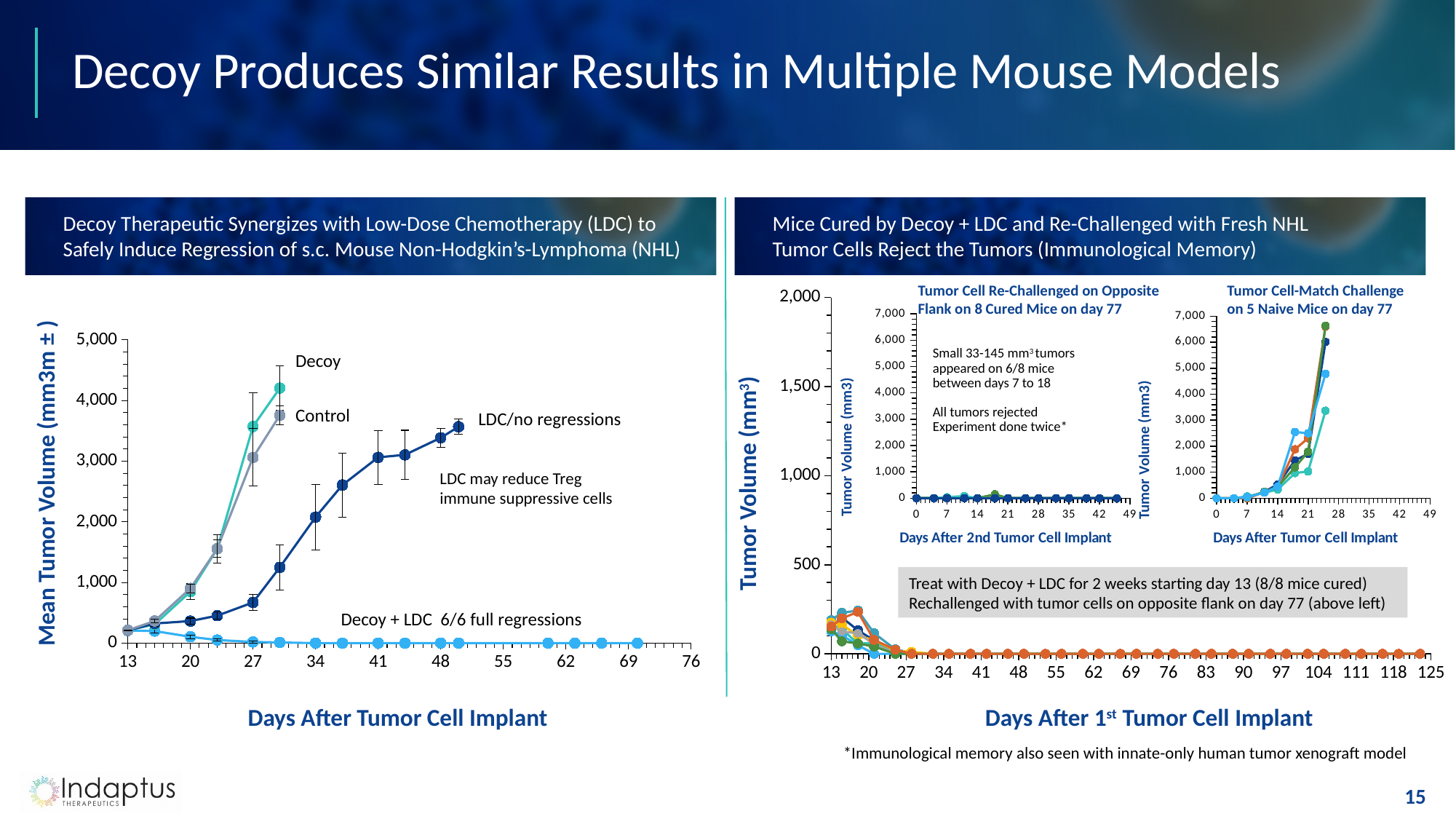
In the left chart, which series stays lowest over the course of the experiment? Decoy + LDC In the left chart, at day 27, which is larger: the Decoy value or the Control value? Decoy In the left chart, which series reaches the highest mean tumor volume? Decoy What kind of chart is the left chart titled 'Days After Tumor Cell Implant'? line chart In the left chart, is the Decoy value at day 27 greater or less than 3,000? greater What is the x-axis label of the right main chart? Days After 1st Tumor Cell Implant In the left chart, does the LDC/no regressions series rise or fall as days increase? rise In the right main chart, are the tumor volume values after day 27 greater or less than 500? less How many labeled tick values are on the x axis of the left chart? 10 In the left chart, does the Decoy + LDC series rise or fall as days increase? fall In the left chart, is the LDC/no regressions value at day 48 greater or less than 3,000? greater